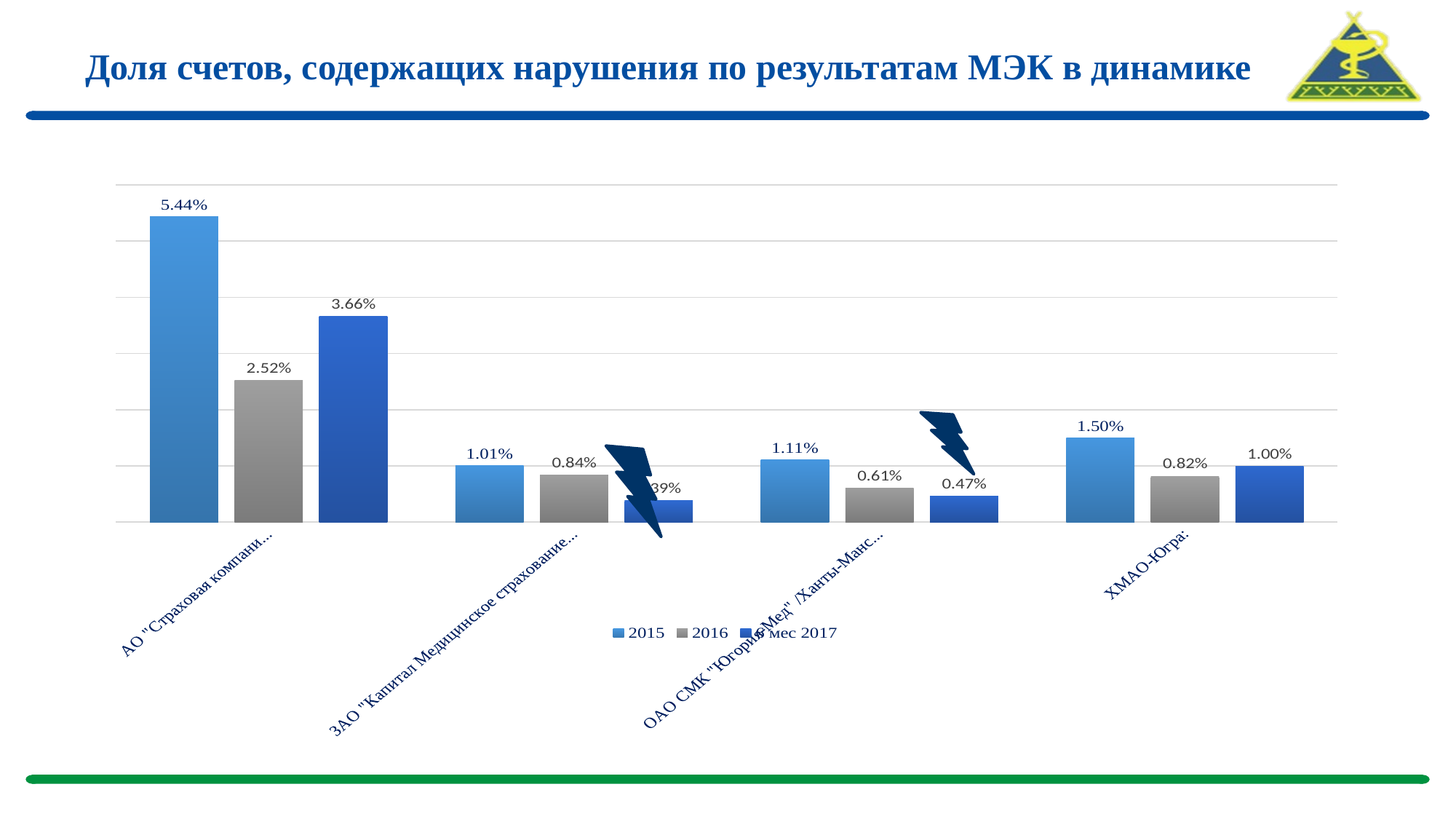
Which category has the lowest 2016 value? ОАО СМК "Югория-Мед" What is the 2015 value for АО "Страховая компани..."? 5.44% How many categories are shown on the x axis? 4 What is the 6 мес 2017 value for ОАО СМК "Югория-Мед"? 0.47% What is the difference between the 2015 and 2016 values for АО "Страховая компани..."? 2.92% What is the title of the slide? Доля счетов, содержащих нарушения по результатам МЭК в динамике How many series does the legend list? 3 What is the 2016 value for ХМАО-Югра? 0.82% Which is larger for ХМАО-Югра: the 2016 value or the 6 мес 2017 value? 6 мес 2017 Which category has the highest 2015 value? АО "Страховая компани..." What is the 2015 value for ЗАО "Капитал Медицинское страхование..."? 1.01% What kind of chart is shown on the slide? Bar chart